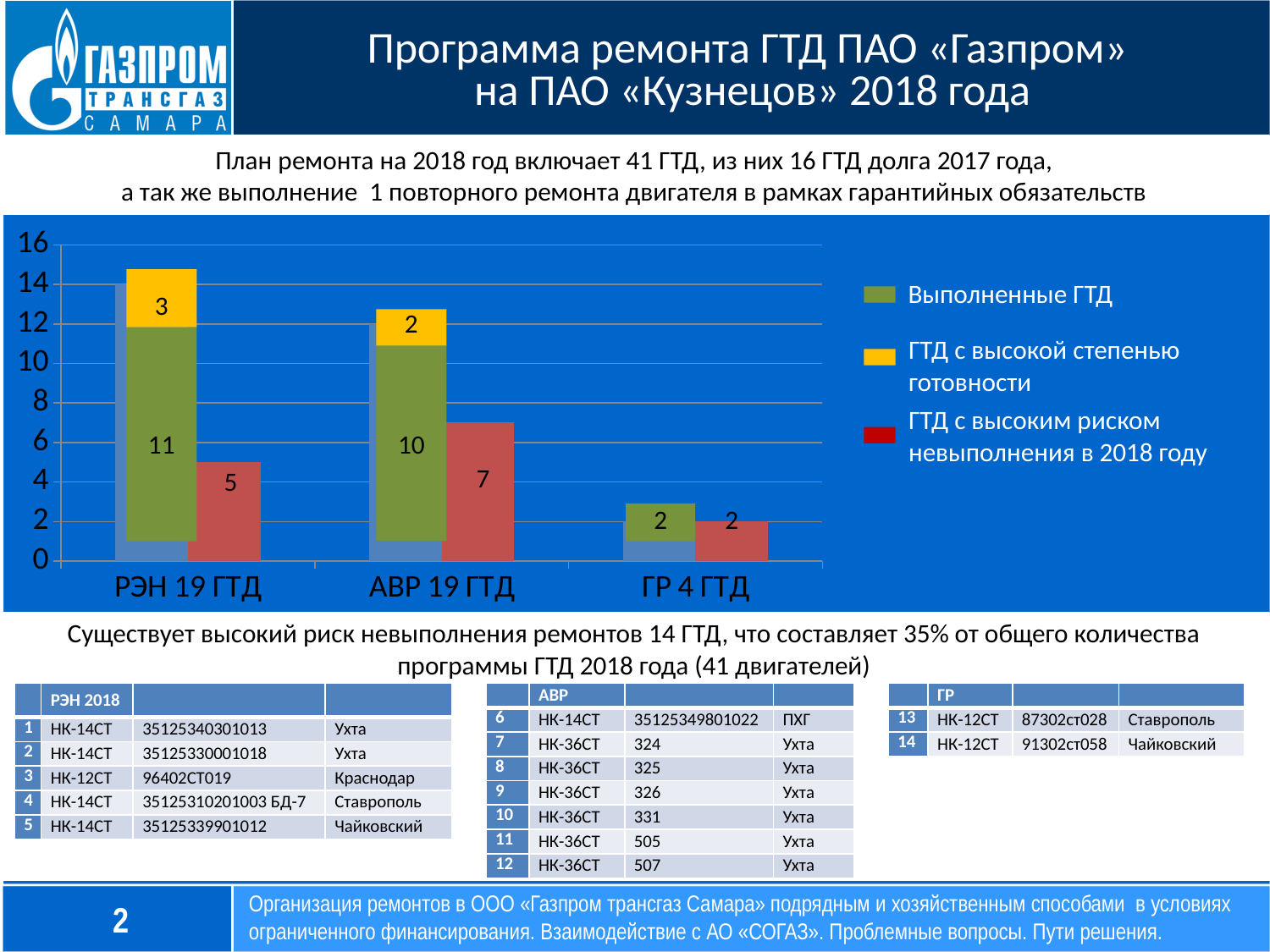
What kind of chart is shown on the slide? bar chart How many series does the chart legend list? 3 Which category has the highest value for «ГТД с высоким риском невыполнения в 2018 году»? АВР 19 ГТД What is the value of «Выполненные ГТД» for РЭН 19 ГТД? 11 How many categories are shown on the x axis of the chart? 3 Which category has the lowest value for «Выполненные ГТД»? ГР 4 ГТД Which is larger: «Выполненные ГТД» for РЭН 19 ГТД or for АВР 19 ГТД? РЭН 19 ГТД What is the difference between the «ГТД с высоким риском невыполнения в 2018 году» values for АВР 19 ГТД and РЭН 19 ГТД? 2 What is the value of «ГТД с высоким риском невыполнения в 2018 году» for ГР 4 ГТД? 2 What is the value of «ГТД с высоким риском невыполнения в 2018 году» for АВР 19 ГТД? 7 What is the value of «ГТД с высокой степенью готовности» for АВР 19 ГТД? 2 What colour represents «Выполненные ГТД» in the chart legend? green